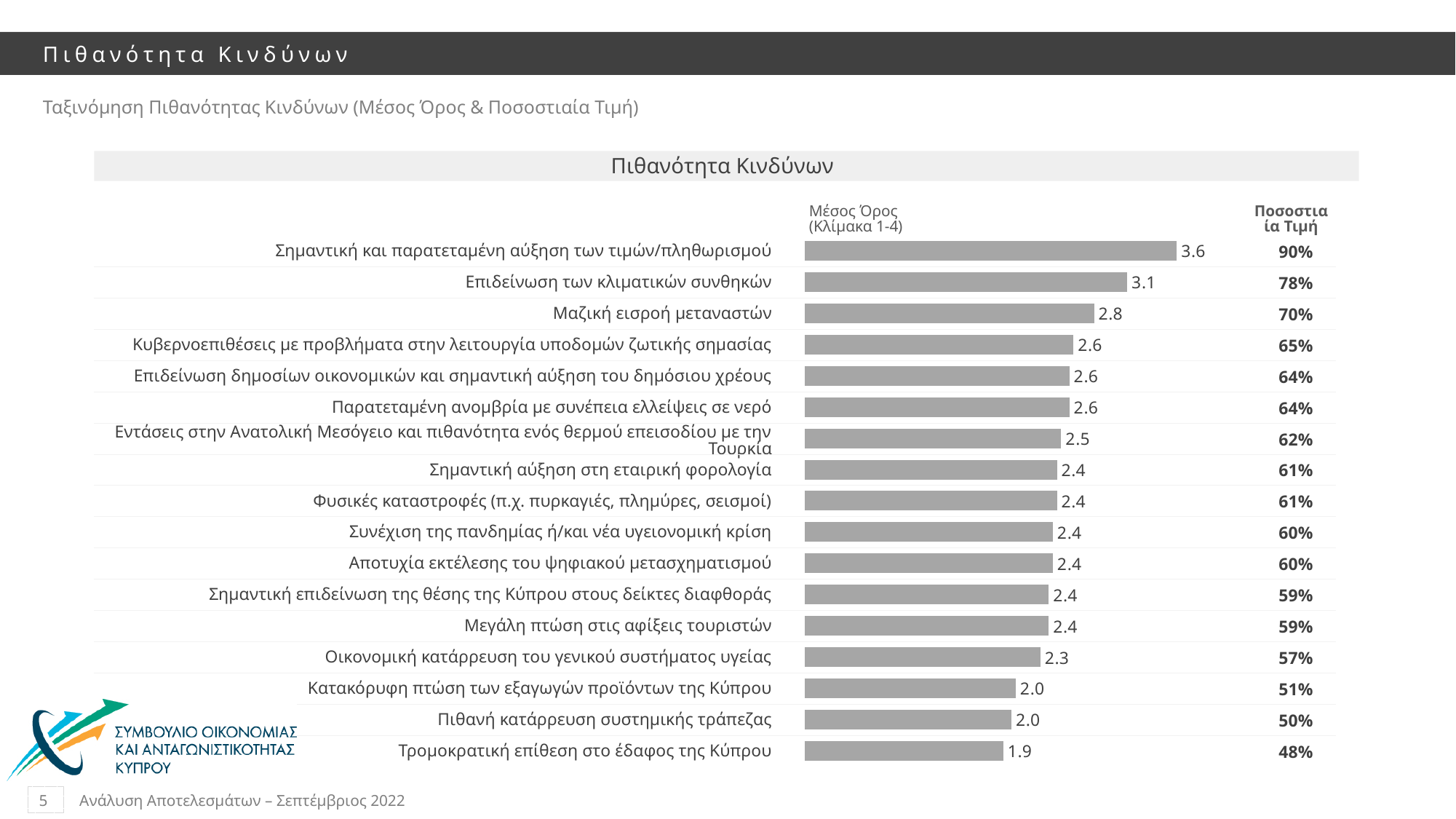
What kind of chart is shown on the slide? Bar chart What is the difference between the average scores of 'Σημαντική και παρατεταμένη αύξηση των τιμών/πληθωρισμού' and 'Επιδείνωση των κλιματικών συνθηκών'? 0.5 What is the percentage value (Ποσοστιαία Τιμή) shown for 'Επιδείνωση των κλιματικών συνθηκών'? 78% What is the average score for 'Τρομοκρατική επίθεση στο έδαφος της Κύπρου'? 1.9 Which risk has the lowest average score? Τρομοκρατική επίθεση στο έδαφος της Κύπρου Which risk has the highest average score? Σημαντική και παρατεταμένη αύξηση των τιμών/πληθωρισμού What is the average score (Μέσος Όρος) for 'Μαζική εισροή μεταναστών'? 2.8 How many risks are listed in the chart? 17 What is the percentage value for 'Κατακόρυφη πτώση των εξαγωγών προϊόντων της Κύπρου'? 51% What is the title of the chart? Πιθανότητα Κινδύνων What is the difference in percentage value between 'Μαζική εισροή μεταναστών' and 'Πιθανή κατάρρευση συστημικής τράπεζας'? 20% Which has a higher average score: 'Κυβερνοεπιθέσεις με προβλήματα στην λειτουργία υποδομών ζωτικής σημασίας' or 'Οικονομική κατάρρευση του γενικού συστήματος υγείας'? Κυβερνοεπιθέσεις με προβλήματα στην λειτουργία υποδομών ζωτικής σημασίας